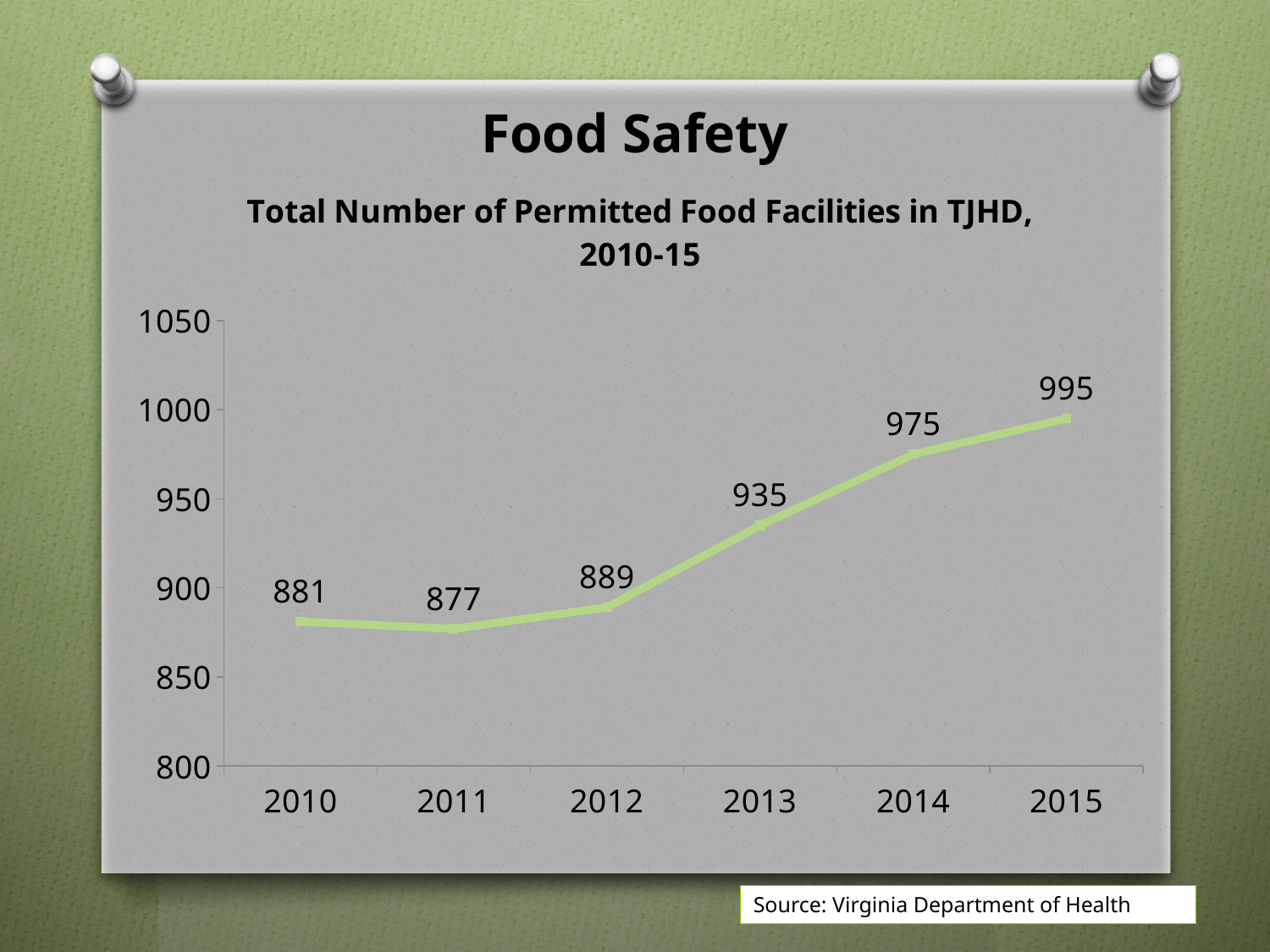
Which year has the lowest number of permitted food facilities? 2011 What is the overall trend in the number of permitted food facilities from 2011 to 2015? Rising Which year has a larger value, 2012 or 2014? 2014 What value is shown for 2010? 881 How many years are plotted on the chart? 6 What value is shown for 2015? 995 By how much did the number of permitted food facilities increase from 2013 to 2014? 40 Is the value for 2013 greater or less than 900? greater Which year has the highest number of permitted food facilities? 2015 What is the difference between the values for 2015 and 2010? 114 What was the total number of permitted food facilities in TJHD in 2013? 935 What kind of chart is shown on the slide? Line chart